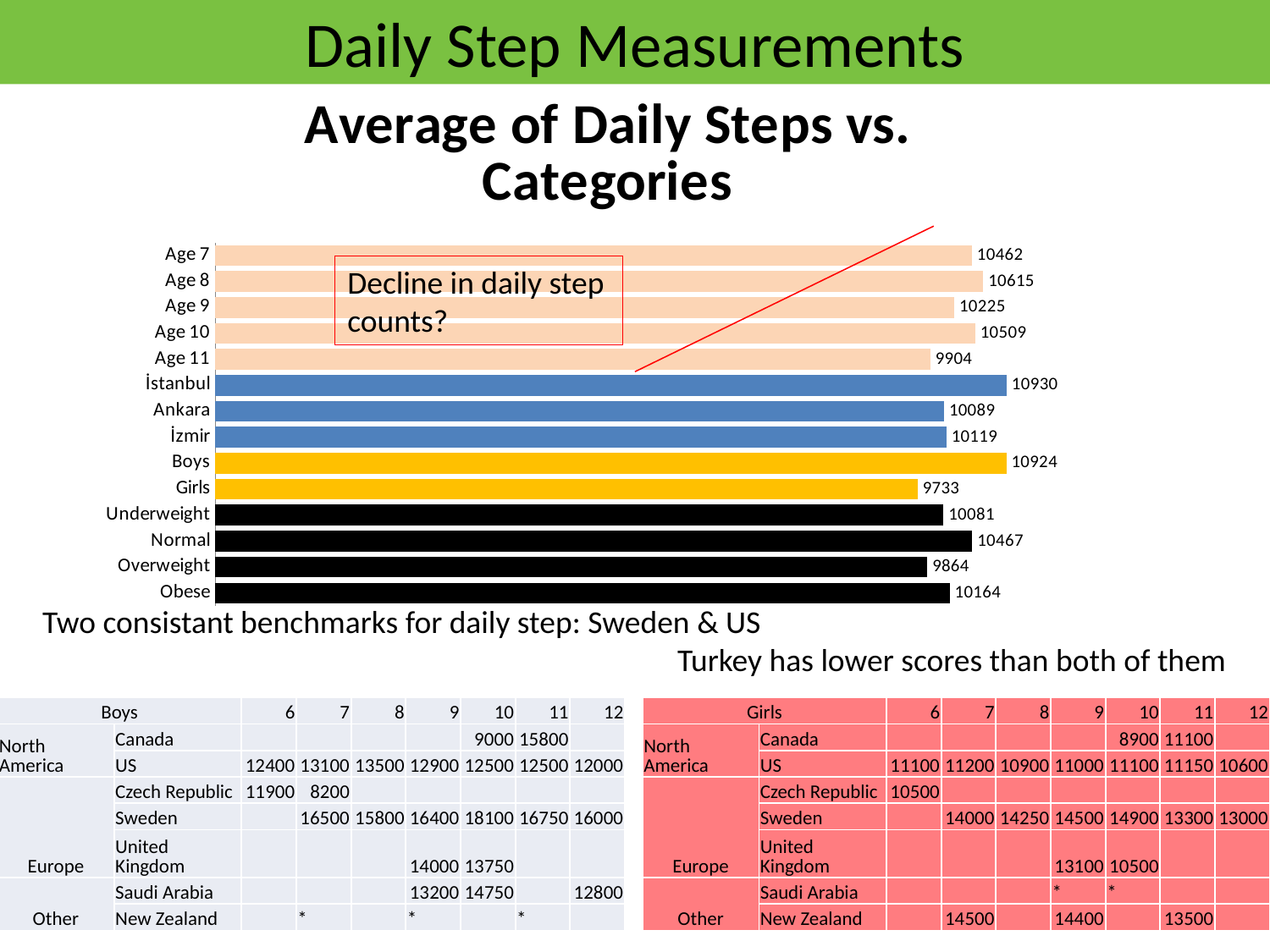
What is the average daily step value for Age 8? 10615 Among the age categories (Age 7 to Age 11), which has the lowest average daily steps? Age 11 What is the average daily step value for Girls? 9733 What does the red-outlined annotation box on the chart say? Decline in daily step counts? Which has a higher average daily step value, Normal or Obese? Normal How many categories are plotted in the chart? 14 What kind of chart is shown on the slide? Bar chart Which category has the lowest average daily steps? Girls What is the difference in average daily steps between İstanbul and Ankara? 841 What is the average daily step value for İstanbul? 10930 What is the average daily step value for Overweight? 9864 What is the difference in average daily steps between Boys and Girls? 1191